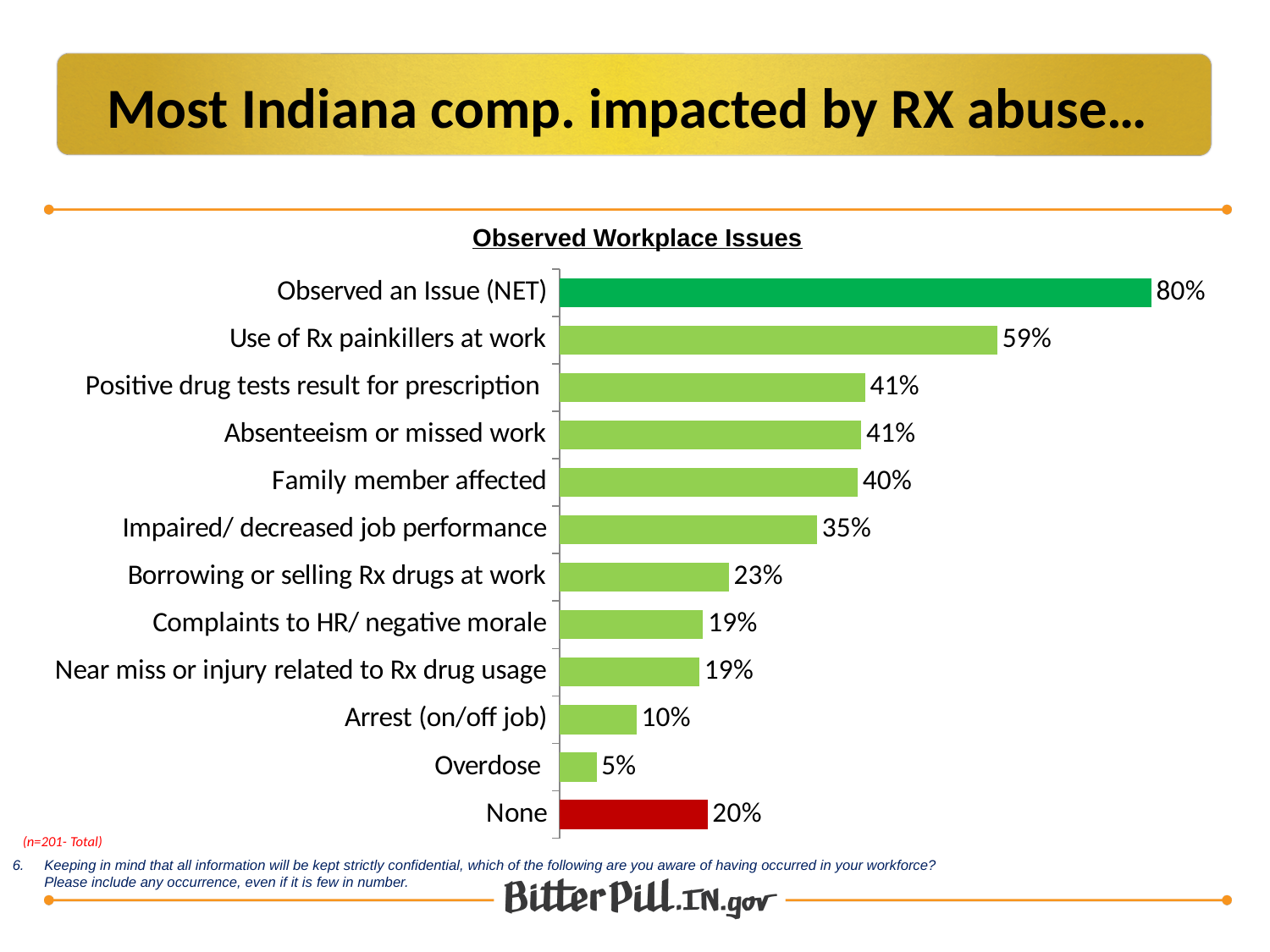
What is the value for "Impaired/ decreased job performance"? 35% Which category's bar is coloured red? None Which is larger: "Borrowing or selling Rx drugs at work" or "None"? Borrowing or selling Rx drugs at work What kind of chart is shown on the slide? Bar chart What is the value for "Overdose"? 5% Which category has the lowest value? Overdose What is the value for "None"? 20% Which category has the highest value? Observed an Issue (NET) What is the difference between "Observed an Issue (NET)" and "Use of Rx painkillers at work"? 21% What is the value for "Use of Rx painkillers at work"? 59% What is the title of the chart? Observed Workplace Issues How many categories are shown in the chart? 12